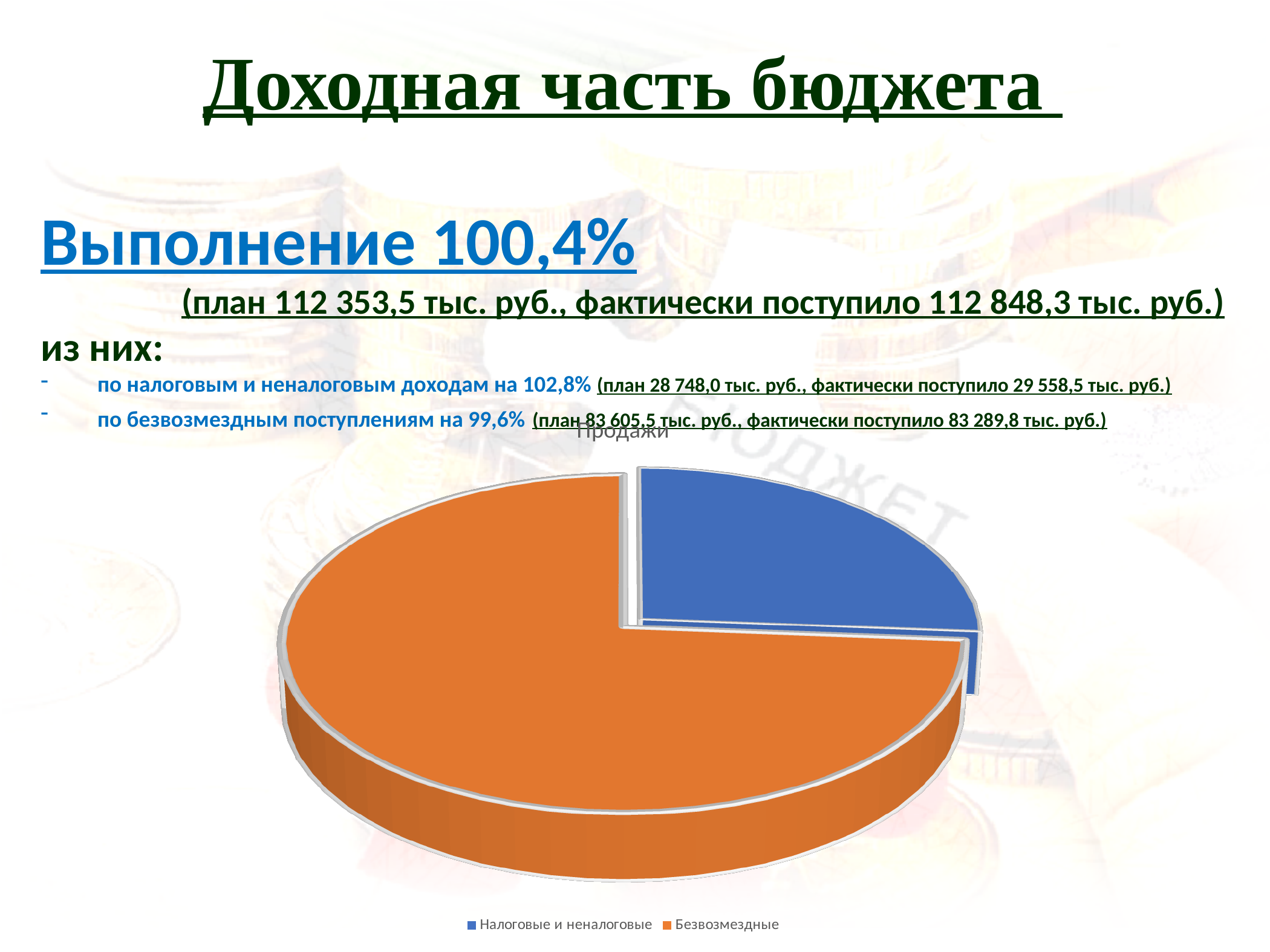
Which slice is larger in the pie chart: Налоговые и неналоговые or Безвозмездные? Безвозмездные Which slice of the pie chart is the smallest? Налоговые и неналоговые Which slice of the pie chart is the largest? Безвозмездные What kind of chart is shown on the slide? Pie chart Which legend entry is shown in blue in the pie chart? Налоговые и неналоговые How many slices does the pie chart have? 2 How many entries does the legend of the pie chart list? 2 What is the title of the pie chart? Продажи What colour is the Безвозмездные slice in the pie chart? Orange